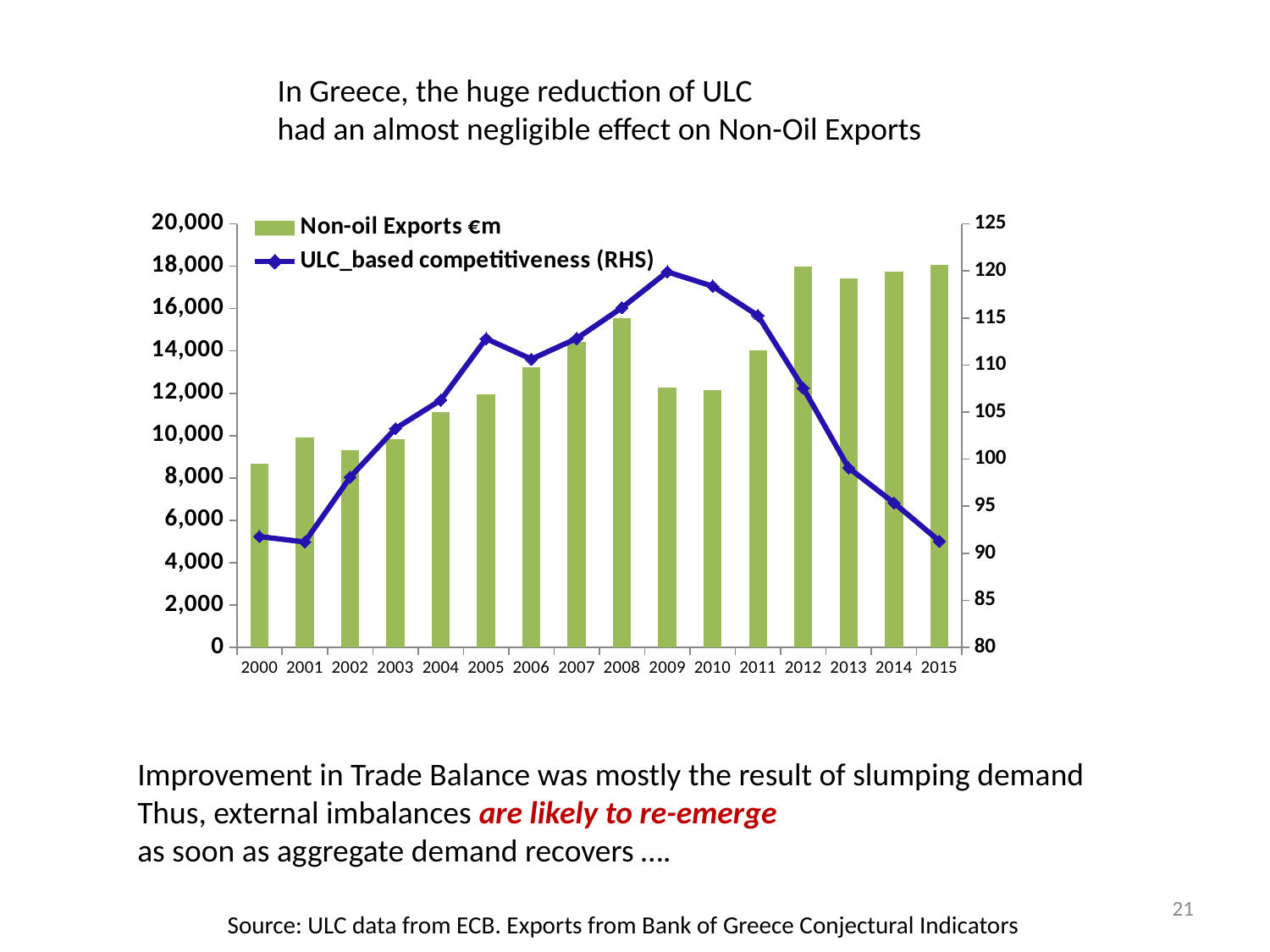
In which year does the ULC_based competitiveness line reach its highest point? 2009 What kind of chart is shown on the slide? Combined bar and line chart Is the Non-oil Exports value for 2009 greater or less than 14,000? less Is the ULC_based competitiveness value for 2014 greater or less than 100? less Which year has the lowest Non-oil Exports bar? 2000 Is the ULC_based competitiveness value for 2009 greater or less than 115? greater Which year has the higher ULC_based competitiveness value, 2005 or 2006? 2005 Which year has the larger Non-oil Exports bar, 2008 or 2009? 2008 Does the ULC_based competitiveness line rise or fall from 2009 to 2015? fall How many series does the chart legend list? 2 How many years are shown on the x axis of the chart? 16